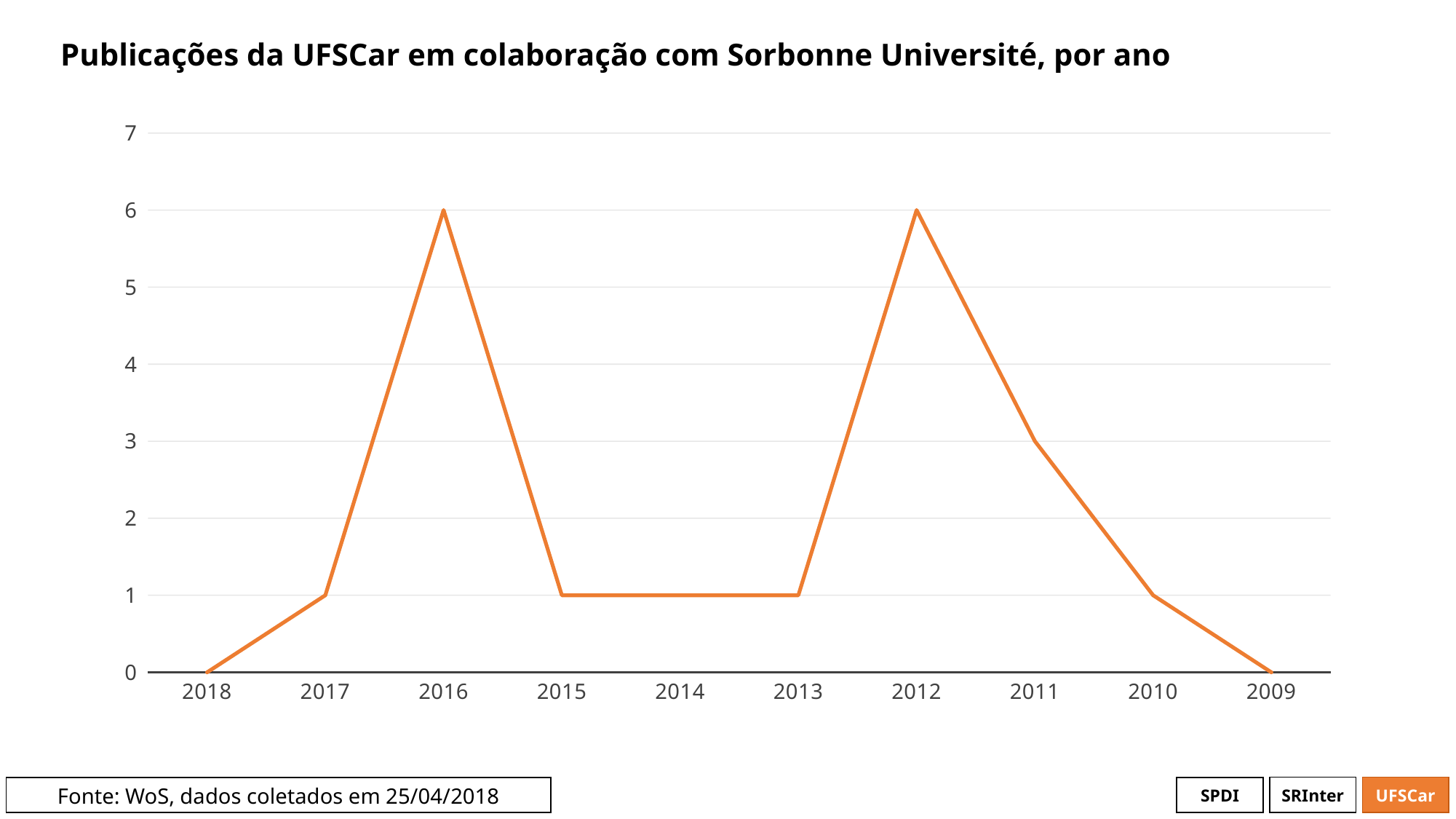
What is the value for 2014? 1 Which is larger, the value for 2011 or the value for 2010? 2011 Is the value for 2012 greater or less than 4? greater What is the value for 2018? 0 How many years are shown on the x axis? 10 What is the highest value reached on the chart? 6 What is the difference between the values for 2012 and 2011? 3 What is the value for 2011? 3 What is the value for 2016? 6 What is the difference between the values for 2016 and 2015? 5 What is the title of the chart? Publicações da UFSCar em colaboração com Sorbonne Université, por ano What kind of chart is this? line chart